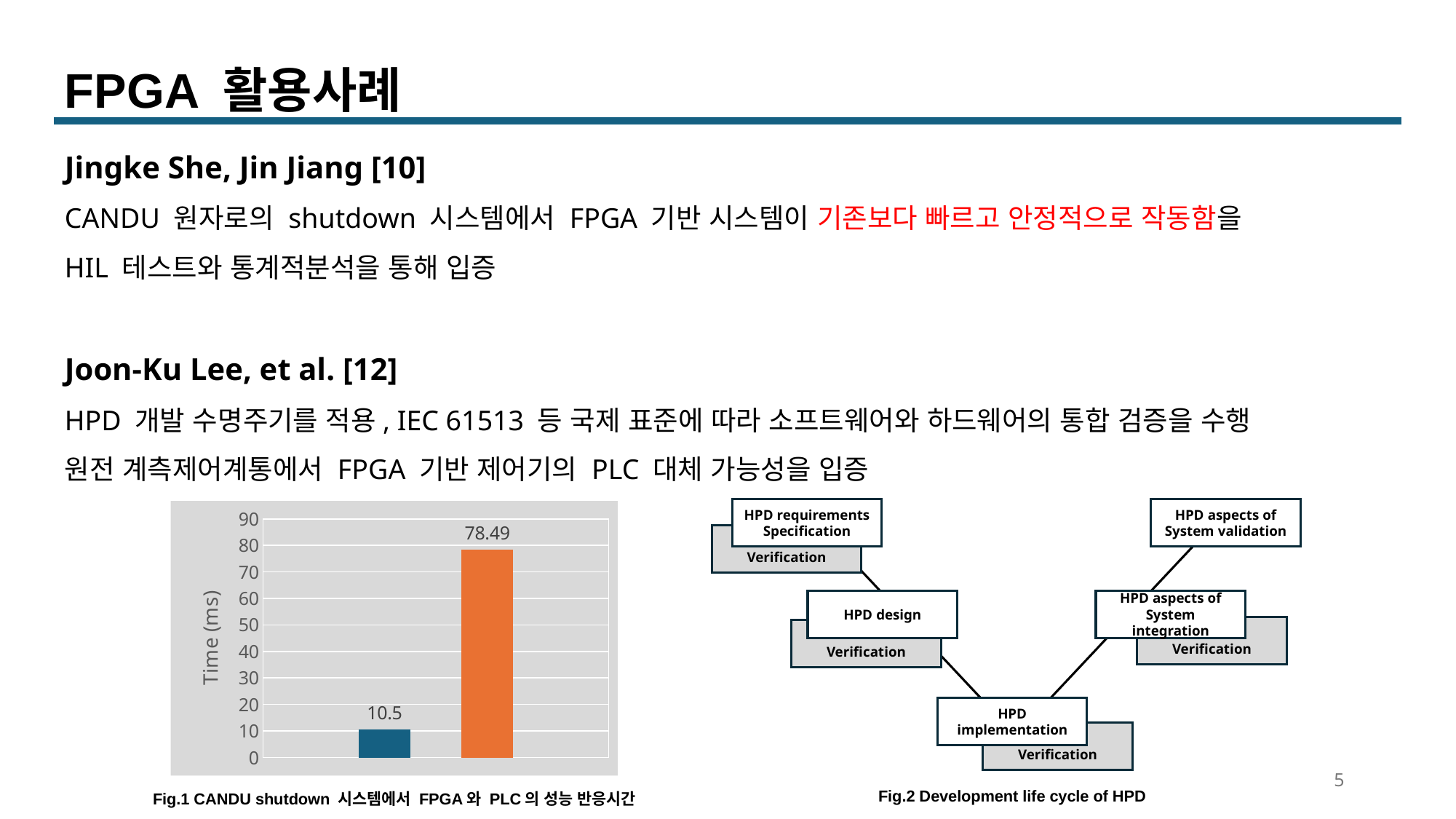
What is the highest tick value shown on the vertical axis of the bar chart (Fig.1)? 90 What is the label of the vertical axis in the bar chart (Fig.1)? Time (ms) How many bars are plotted in the bar chart (Fig.1)? 2 In the bar chart (Fig.1), which bar has the lowest value, the blue one or the orange one? the blue bar What type of chart is Fig.1 on the slide? bar chart In the bar chart (Fig.1), what is the value of the orange bar? 78.49 In the bar chart (Fig.1), is the value of the orange bar greater or less than 70? greater In the bar chart (Fig.1), what is the value of the blue bar? 10.5 In the bar chart (Fig.1), which bar has the highest value, the blue one or the orange one? the orange bar In the bar chart (Fig.1), is the value of the blue bar greater or less than 20? less In the bar chart (Fig.1), is the blue bar larger or smaller than the orange bar? smaller In the bar chart (Fig.1), what is the difference between the orange bar and the blue bar? 67.99